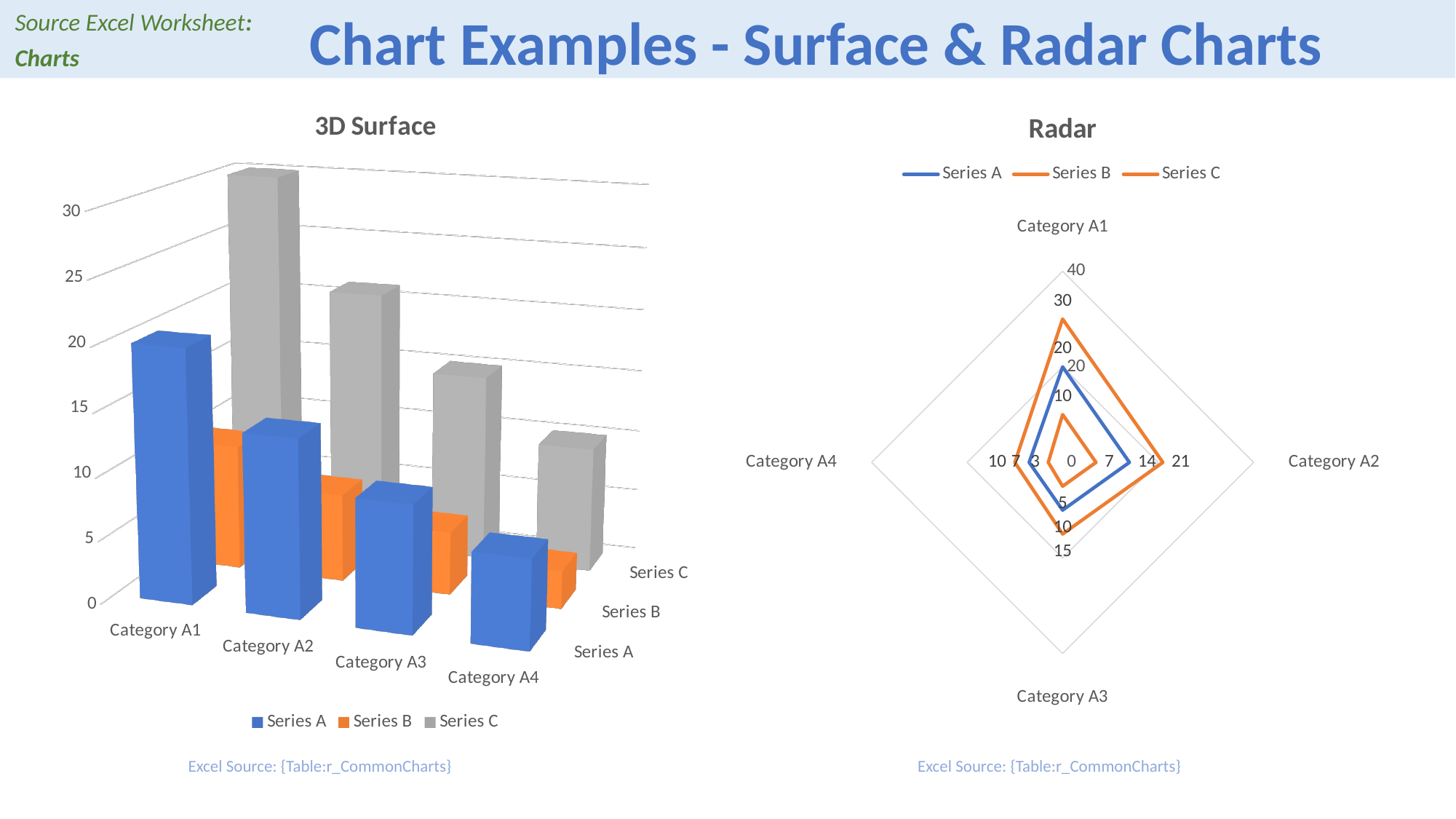
In the Radar chart, which category has the lowest value for Series A? Category A4 What kind of chart is the chart titled "3D Surface"? bar chart How many series does the legend of the Radar chart list? 3 In the Radar chart, what is the value of Series A for Category A2? 14 In the 3D Surface chart, is the value of Series C for Category A1 greater or less than 25? greater In the Radar chart, what is the value of Series A for Category A4? 7 In the 3D Surface chart, which category has the highest value for Series C? Category A1 In the Radar chart, what is the value of Series A for Category A1? 20 In the 3D Surface chart, do the Series A values rise or fall from Category A1 to Category A4? fall In the Radar chart, what is the difference between the Series A values for Category A1 and Category A2? 6 How many categories are plotted in the Radar chart? 4 In the Radar chart, which category has the highest value for Series A? Category A1